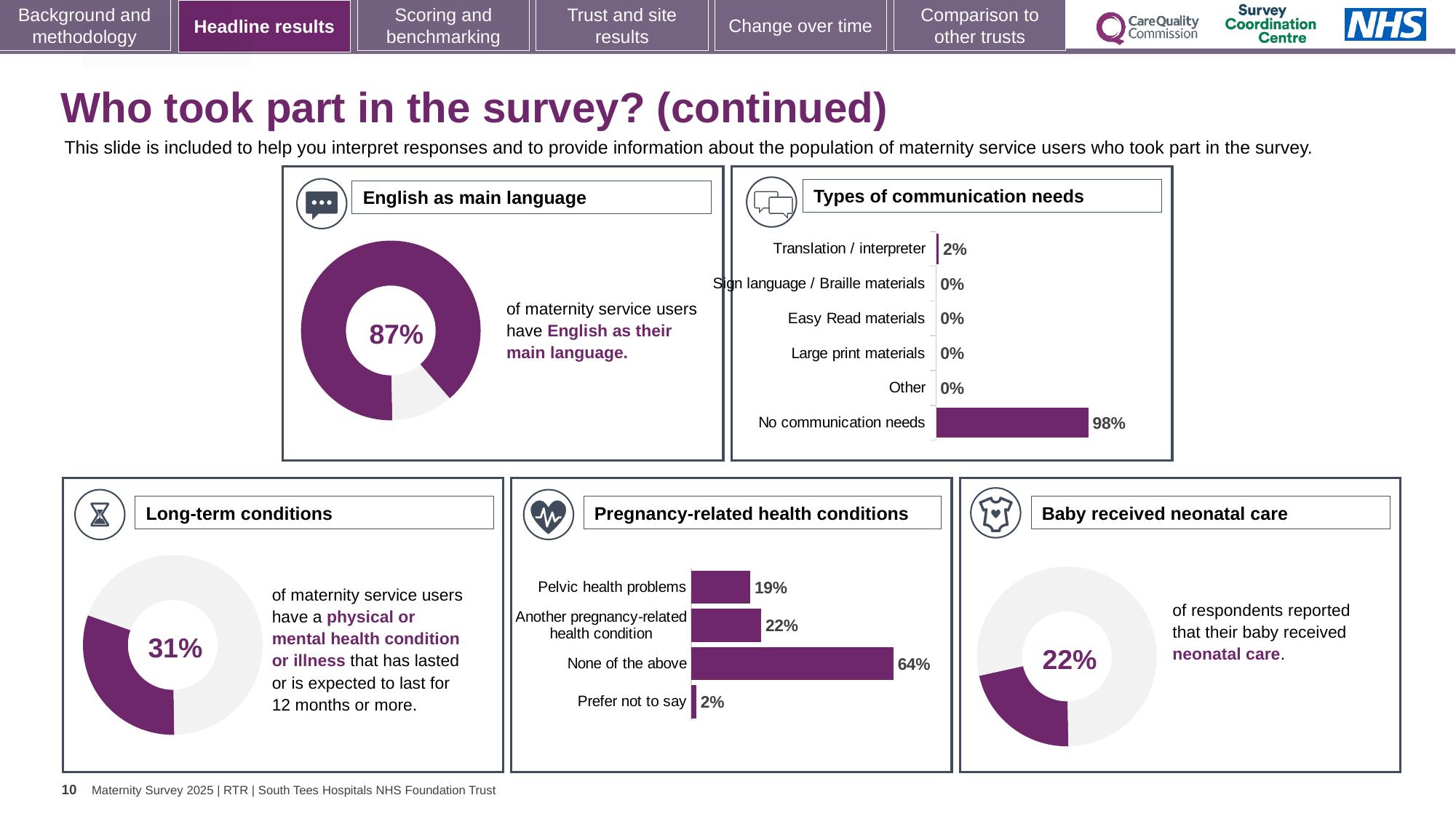
In the 'Pregnancy-related health conditions' chart, what is the difference between 'None of the above' and 'Another pregnancy-related health condition'? 42% What percentage is shown in the 'Baby received neonatal care' donut chart? 22% In the 'Pregnancy-related health conditions' chart, which category has the lowest value? Prefer not to say In the 'Types of communication needs' chart, which category has the highest value? No communication needs How many categories are shown in the 'Types of communication needs' chart? 6 What percentage is shown in the 'Long-term conditions' donut chart? 31% In the 'Pregnancy-related health conditions' chart, what is the value for 'Pelvic health problems'? 19% What kind of chart is the 'Pregnancy-related health conditions' chart? Bar chart In the 'Types of communication needs' chart, what is the value for 'Translation / interpreter'? 2% In the 'Pregnancy-related health conditions' chart, which is larger: 'Pelvic health problems' or 'Another pregnancy-related health condition'? Another pregnancy-related health condition What percentage is shown in the 'English as main language' donut chart? 87% In the 'Types of communication needs' chart, what is the value for 'No communication needs'? 98%